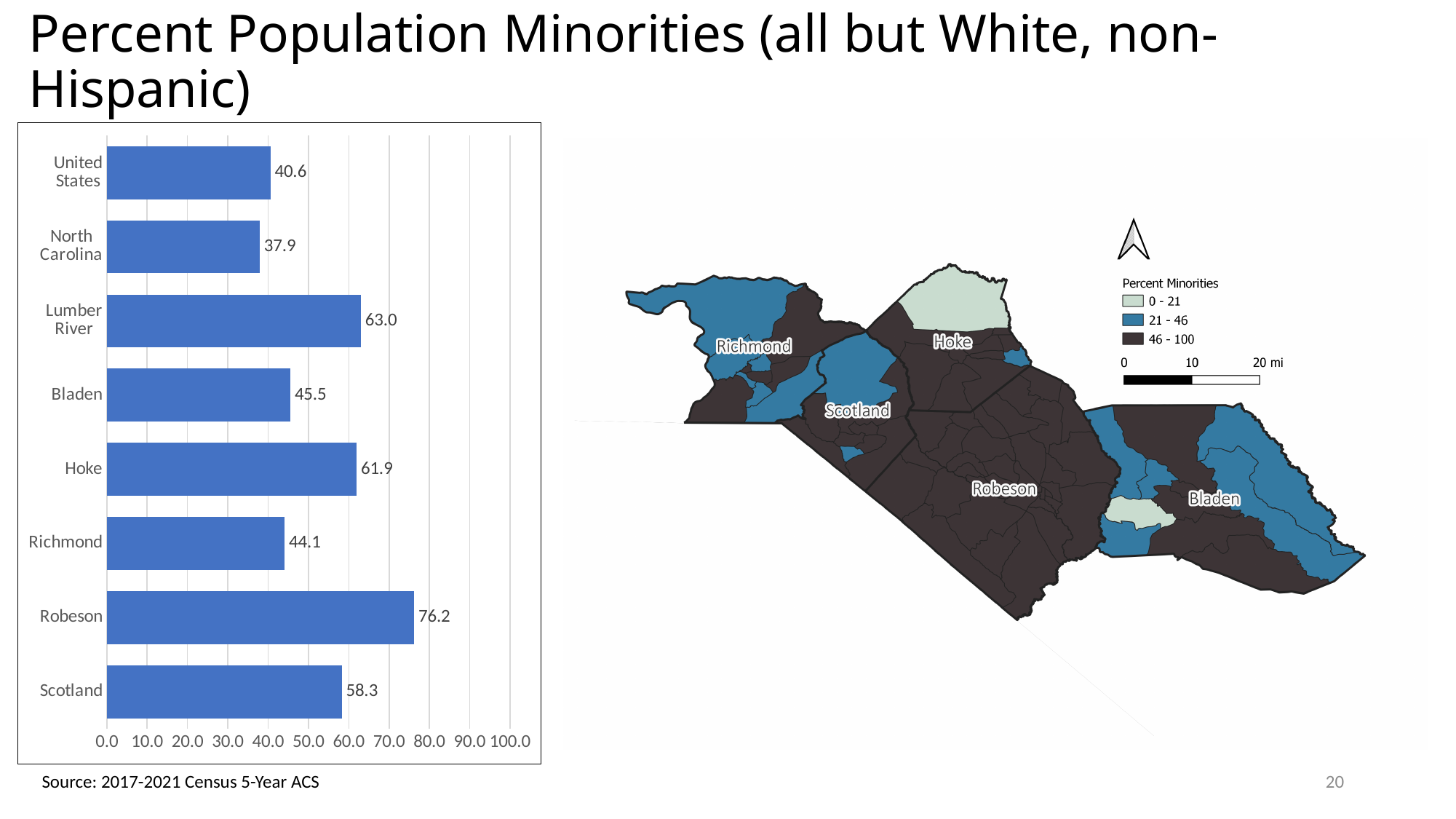
Which has a higher percent population minorities, Hoke or Bladen? Hoke How many categories are shown in the bar chart? 8 What is the percent population minorities for Robeson? 76.2 Is the value for Richmond greater or less than 50.0? less What kind of chart is shown on the left of the slide? bar chart What is the difference between the values for the United States and North Carolina? 2.7 What is the percent population minorities for North Carolina? 37.9 What is the percent population minorities for Lumber River? 63.0 What is the data source cited below the bar chart? 2017-2021 Census 5-Year ACS Which category has the highest percent population minorities? Robeson What is the difference between the values for Robeson and Scotland? 17.9 Which category has the lowest percent population minorities? North Carolina